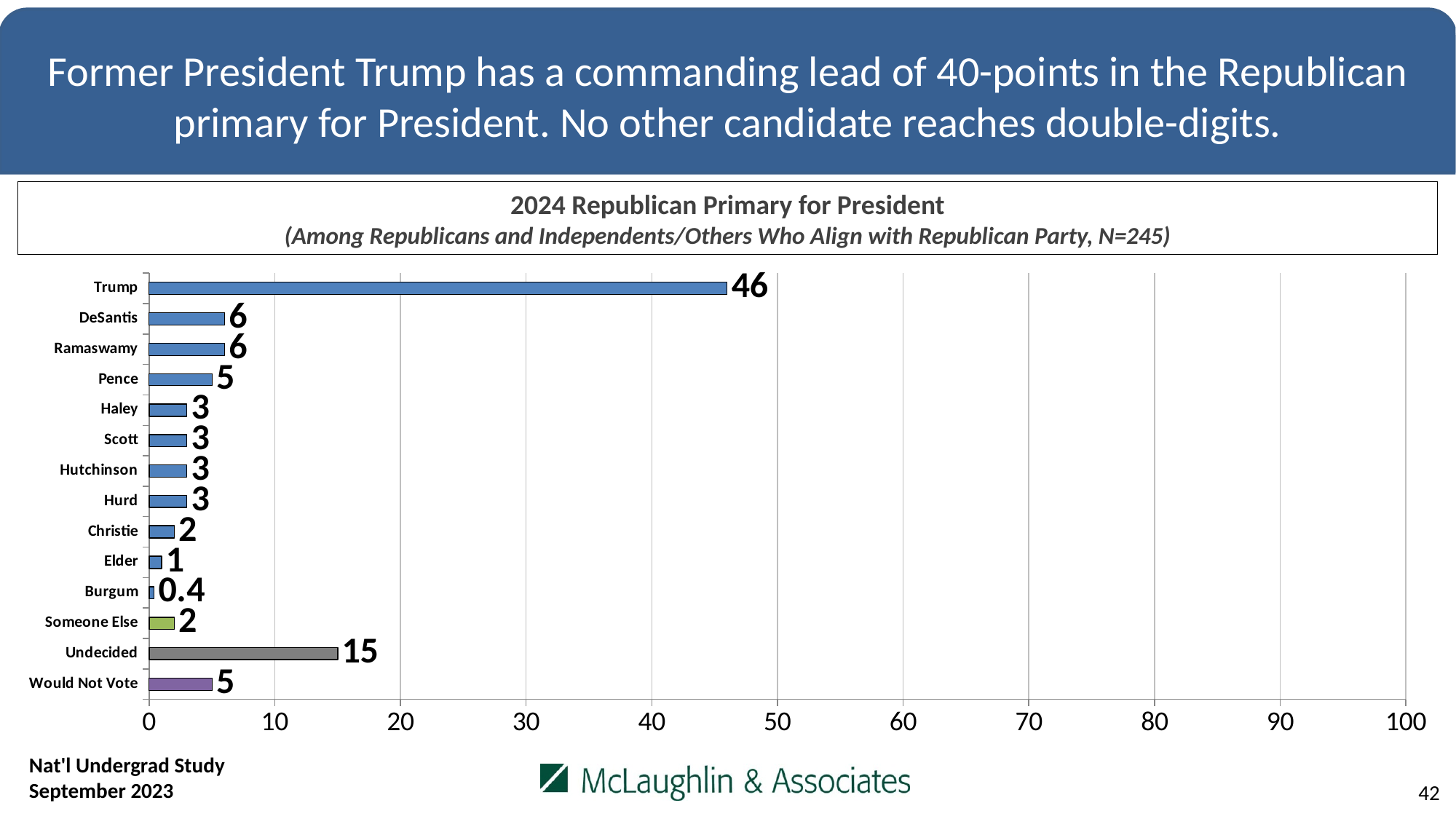
What kind of chart is shown on the slide? bar chart What is the value for Pence? 5 Which is larger, the value for Christie or the value for Elder? Christie What is the difference between the values for Trump and DeSantis? 40 What is the difference between the values for Undecided and Would Not Vote? 10 What is the value for Trump? 46 Is the value for Trump greater or less than 40? greater How many categories are shown on the chart? 14 What is the value for Burgum? 0.4 What is the value for Undecided? 15 Which category has the highest value? Trump Which category has the lowest value? Burgum